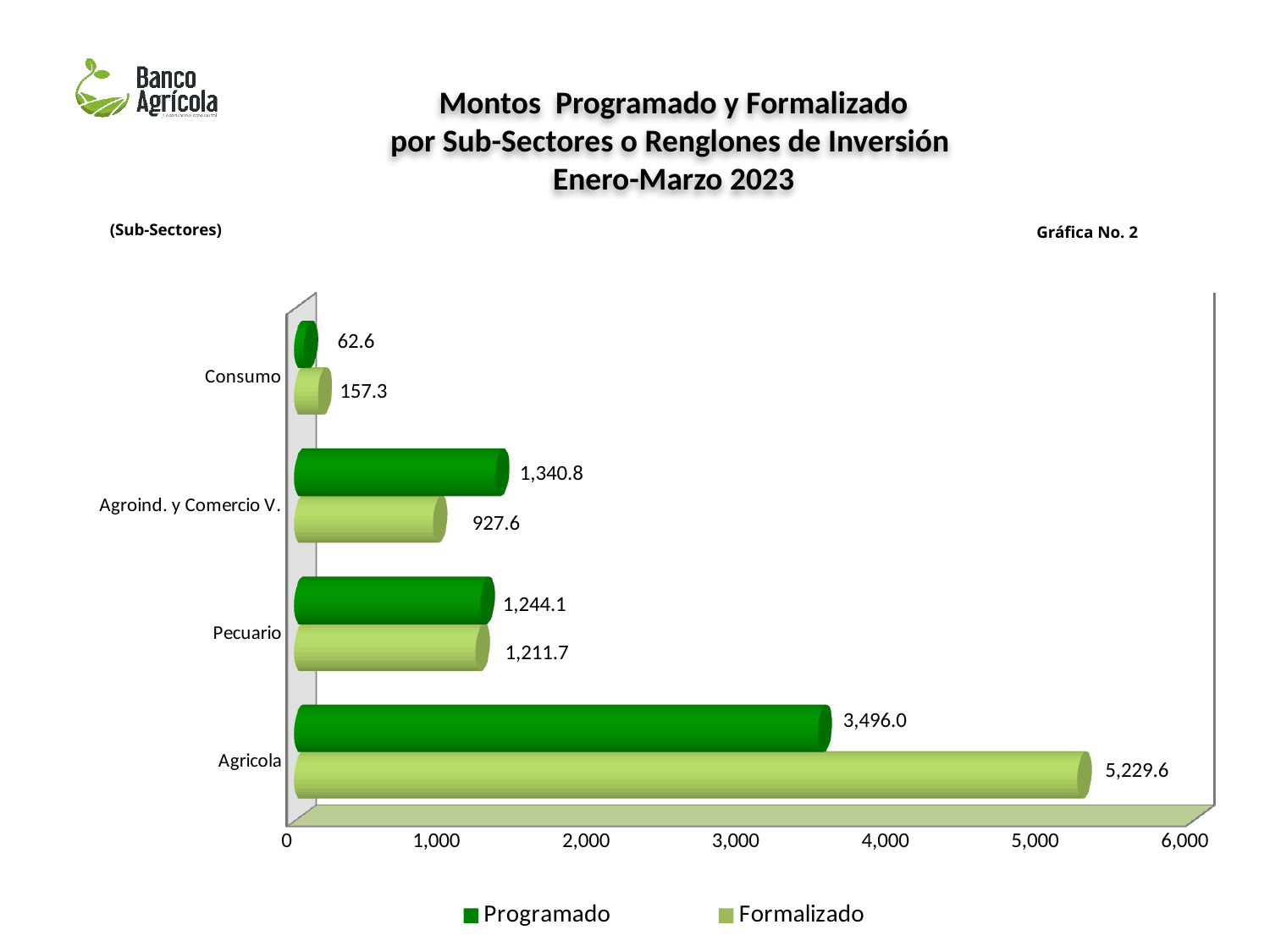
What is the Programado value for Pecuario? 1,244.1 How many sub-sectors are shown on the chart? 4 Which sub-sector has the lowest Programado value? Consumo What kind of chart is shown on the slide? Bar chart What is the difference between the Formalizado and Programado values for Agricola? 1,733.6 Which sub-sector has the highest Formalizado value? Agricola How many series does the legend list? 2 What is the Programado value for Agricola? 3,496.0 What is the difference between the Programado and Formalizado values for Agroind. y Comercio V.? 413.2 What is the Formalizado value for Agroind. y Comercio V.? 927.6 What is the Formalizado value for Consumo? 157.3 For Agroind. y Comercio V., which is larger, the Programado or the Formalizado value? Programado